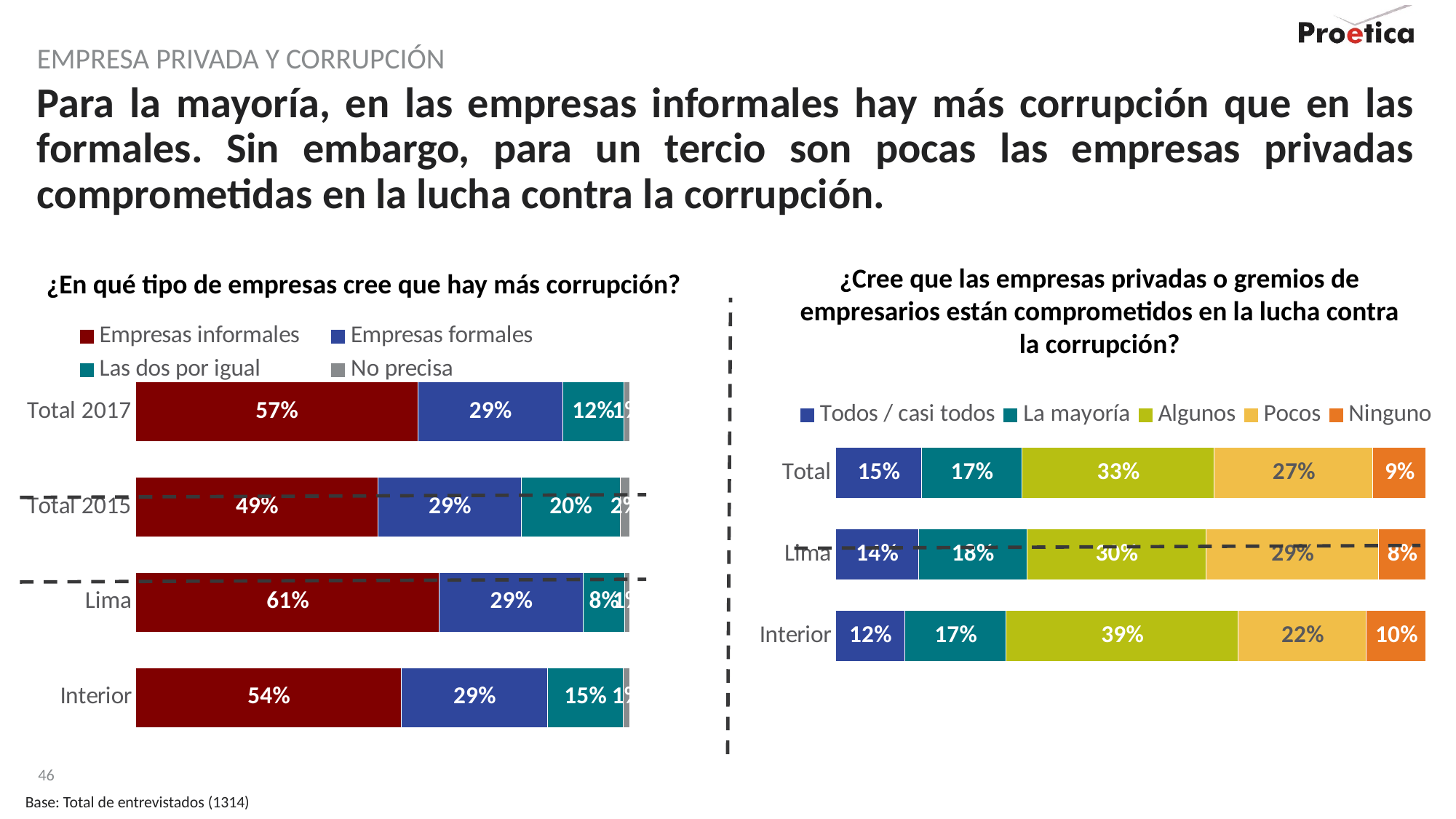
In the chart on the right about private companies committed to fighting corruption, how many categories are shown? 3 In the chart on the right about private companies committed to fighting corruption, what is the value for Pocos in Interior? 22% In the chart on the right about private companies committed to fighting corruption, which category has the highest value for Algunos? Interior In the chart on the right about private companies committed to fighting corruption, is the Ninguno value larger for Total or for Interior? Interior In the chart on the right about private companies committed to fighting corruption, what percentage of Total respondents answered Algunos? 33% In the chart '¿En qué tipo de empresas cree que hay más corrupción?', which category has the highest value for Empresas informales? Lima In the chart '¿En qué tipo de empresas cree que hay más corrupción?', which category has the lowest value for Empresas informales? Total 2015 In the chart '¿En qué tipo de empresas cree que hay más corrupción?', what is the difference between the Empresas informales values for Lima and Interior? 7 percentage points What type of chart is used on the right side of the slide? Stacked bar chart In the chart '¿En qué tipo de empresas cree que hay más corrupción?', what percentage of Total 2017 respondents chose Empresas informales? 57% In the chart '¿En qué tipo de empresas cree que hay más corrupción?', what is the value for Las dos por igual in Total 2015? 20% In the chart '¿En qué tipo de empresas cree que hay más corrupción?', how many series does the legend list? 4